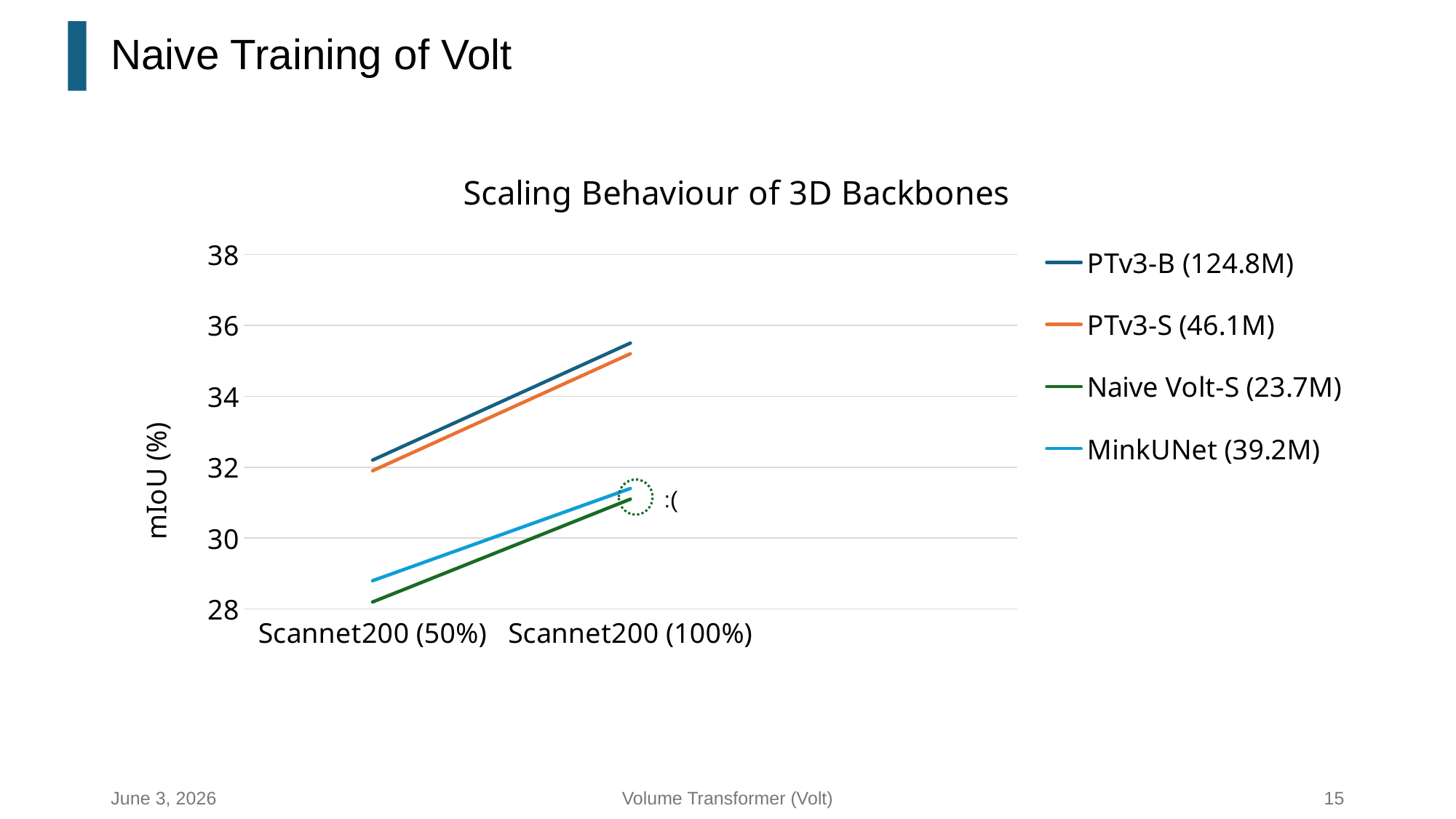
Is the value for PTv3-B (124.8M) at Scannet200 (100%) greater or less than 34? greater Is the value for Naive Volt-S (23.7M) at Scannet200 (50%) greater or less than 30? less How many series does the legend list? 4 Is the value for PTv3-S (46.1M) at Scannet200 (100%) greater or less than 36? less What is the label of the y axis? mIoU (%) Do the values for Naive Volt-S (23.7M) rise or fall from Scannet200 (50%) to Scannet200 (100%)? rise What kind of chart is shown on the slide? line chart Which is larger at Scannet200 (100%): the value for PTv3-B (124.8M) or the value for Naive Volt-S (23.7M)? PTv3-B (124.8M) How many categories are shown on the x axis? 2 What is the title of the chart? Scaling Behaviour of 3D Backbones Which series has the lowest value at Scannet200 (50%)? Naive Volt-S (23.7M)